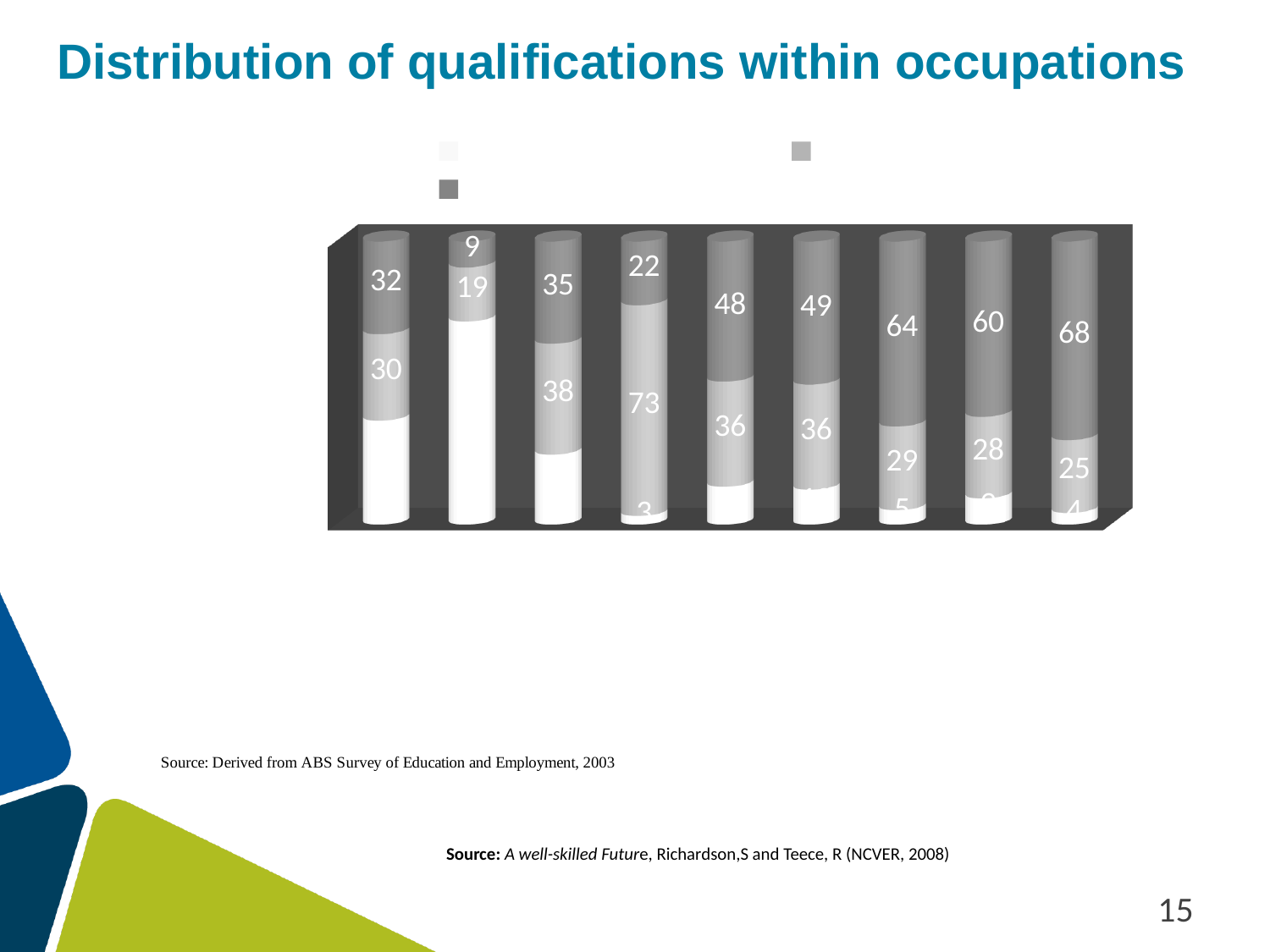
What kind of chart is shown on the slide? stacked bar chart What is the value labelled on the top segment of the leftmost bar? 32 What is the value labelled on the middle segment of the leftmost bar? 30 What is the value labelled on the top segment of the rightmost bar? 68 Which bar has the highest value on its top segment? the rightmost bar (68) Which is larger: the top-segment value of the seventh bar from the left or the eighth bar from the left? the seventh bar (64) Do the top-segment values generally rise or fall from the third bar to the rightmost bar? rise What is the difference between the top-segment values of the rightmost bar and the leftmost bar? 36 How many bars are plotted in the chart? 9 Which bar has the lowest value on its top segment? the second bar from the left (9) What is the value labelled on the middle segment of the fourth bar from the left? 73 What is the title of the chart? Distribution of qualifications within occupations